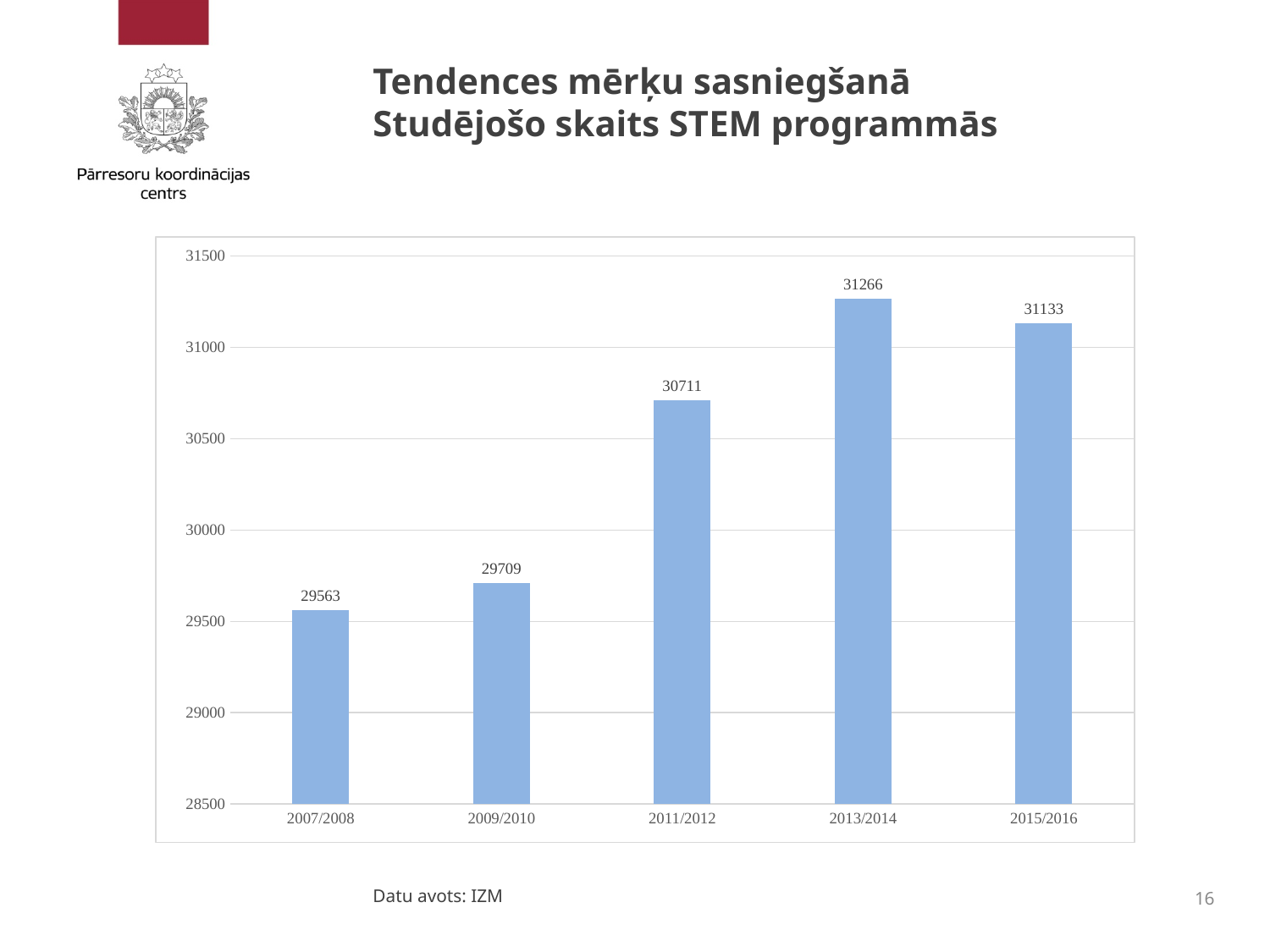
Which academic year has the highest value? 2013/2014 Which is larger, the value for 2011/2012 or the value for 2009/2010? 2011/2012 Which academic year has the lowest value? 2007/2008 How many academic years are shown on the x axis? 5 Is the value for 2011/2012 greater or less than 30500? greater What kind of chart is shown on the slide? bar chart Do the values rise or fall from 2007/2008 to 2013/2014? rise What is the value for 2011/2012? 30711 What is the difference between the values for 2009/2010 and 2007/2008? 146 What is the value for 2007/2008? 29563 What is the difference between the values for 2013/2014 and 2015/2016? 133 What is the value for 2015/2016? 31133